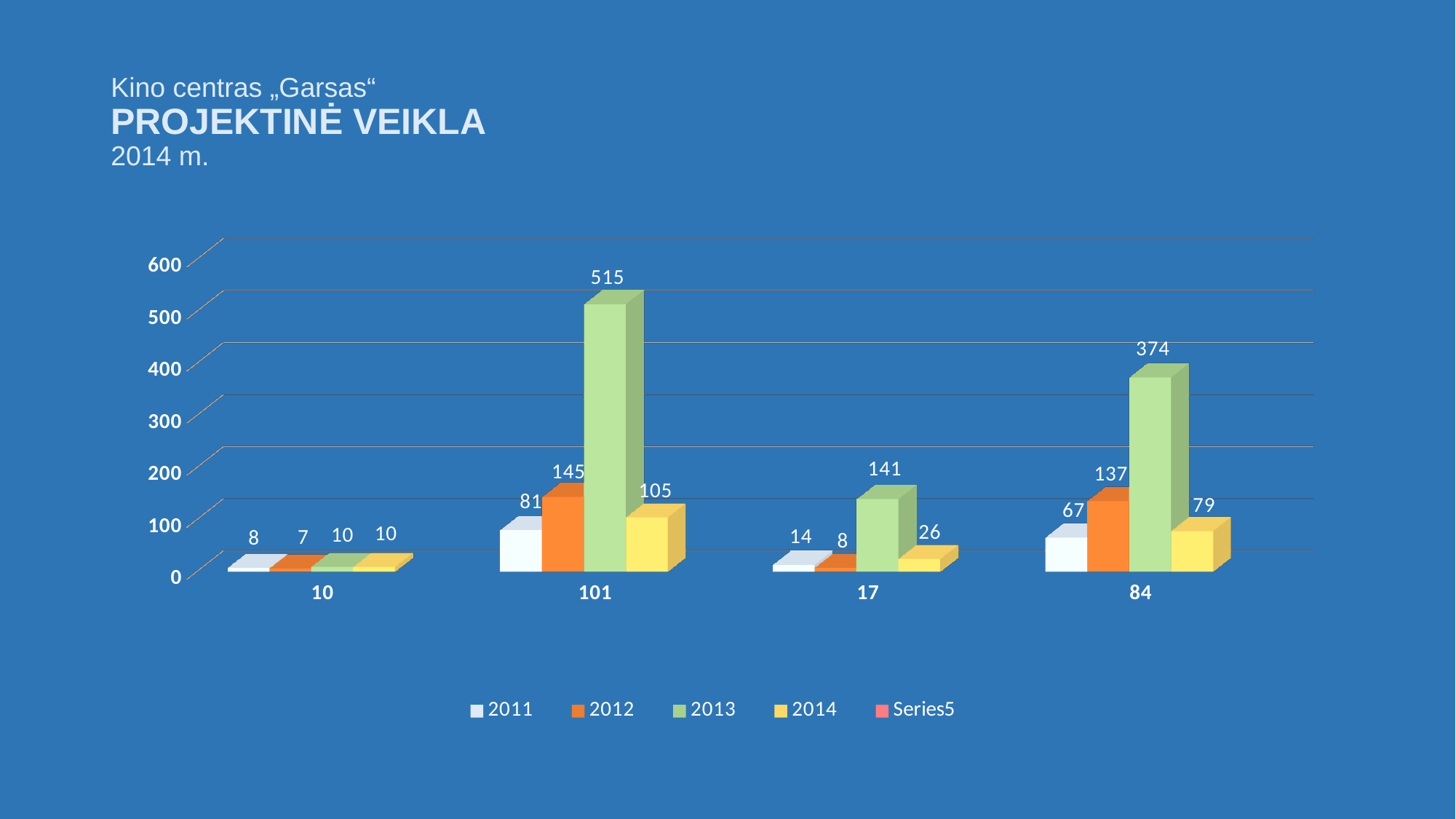
What is the last entry in the chart legend? Series5 What is the value for the 2012 series in the category labelled 84? 137 What kind of chart is shown on the slide? Bar chart What is the value for the 2013 series in the category labelled 101? 515 How many categories are shown on the x axis? 4 Which category has the highest value for the 2013 series? 101 How many series does the legend list? 5 What is the value for the 2014 series in the category labelled 17? 26 What is the difference between the 2013 and 2014 values in the category labelled 84? 295 In the category labelled 17, which series has the larger value, 2011 or 2014? 2014 What is the value for the 2011 series in the category labelled 10? 8 Which category has the lowest value for the 2012 series? 10